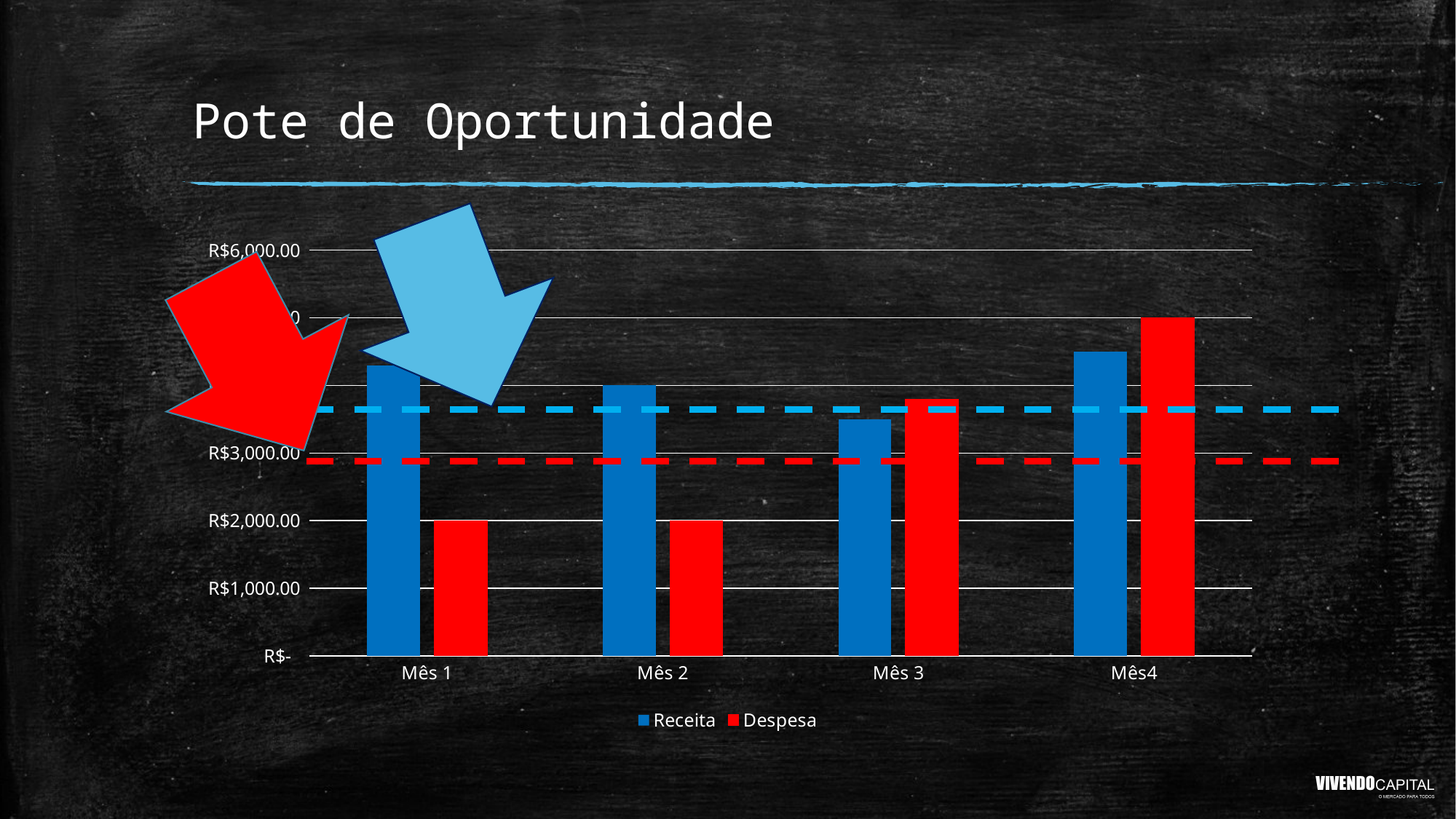
How many categories are shown on the x axis? 4 Which month has the lowest Receita? Mês 3 In Mês 1, which is larger, Receita or Despesa? Receita How many series does the legend list? 2 Which month has the highest Despesa? Mês4 Is the Despesa value for Mês4 greater or less than R$3,000.00? greater In Mês4, which is larger, Receita or Despesa? Despesa What is the Despesa value for Mês 1? R$2,000.00 Is the Receita value for Mês 1 greater or less than R$3,000.00? greater What is the Despesa value for Mês 2? R$2,000.00 Which series is shown in red in the legend? Despesa What type of chart is shown on the slide? Bar chart